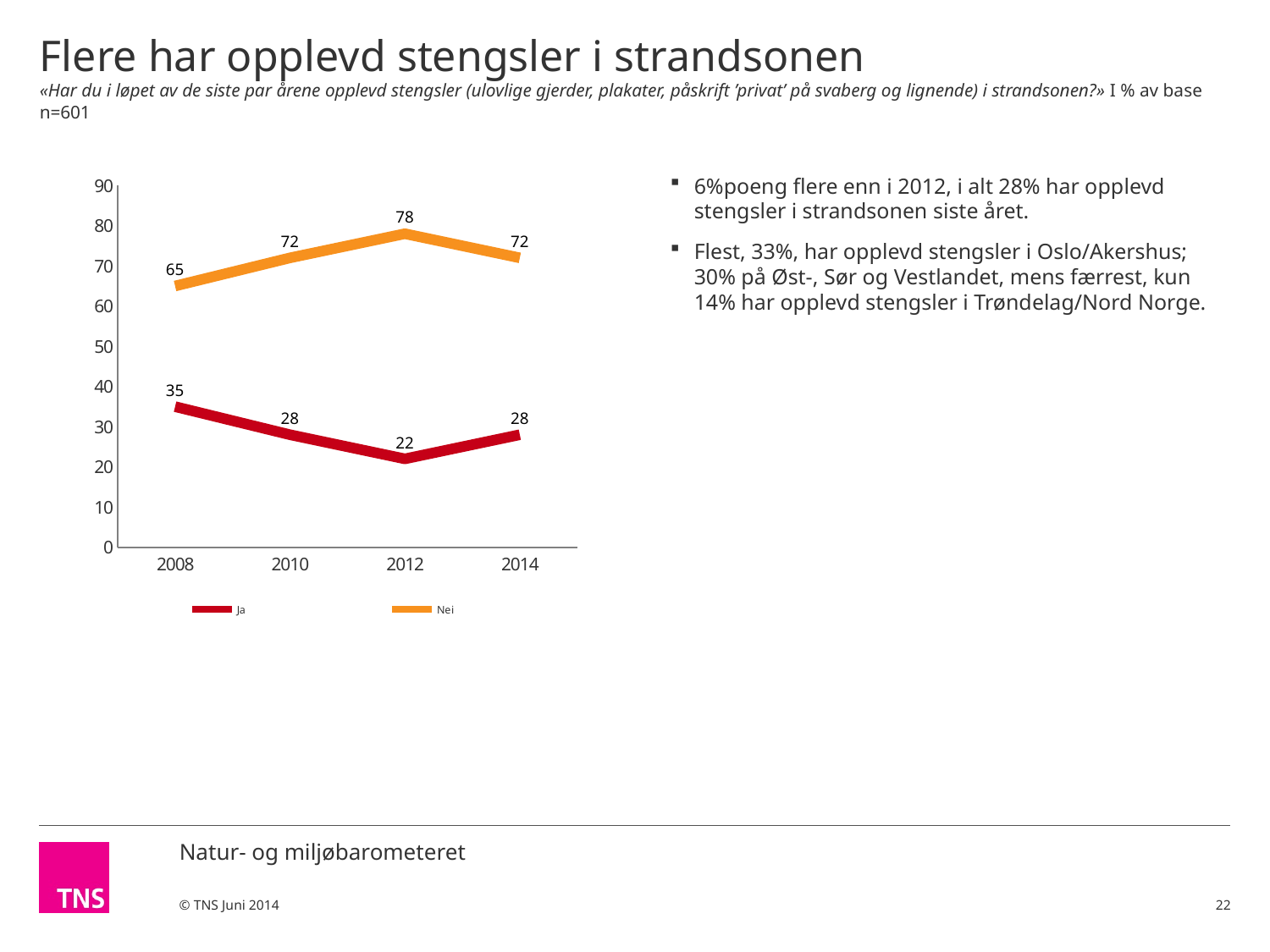
What is the value for "Nei" in 2012? 78 What kind of chart is shown on the slide? line chart Is the value for "Nei" in 2008 greater or less than 60? greater How many years are shown on the x axis? 4 Which is larger: the "Ja" value in 2008 or the "Ja" value in 2010? 2008 What is the difference between the "Nei" value in 2012 and the "Nei" value in 2008? 13 What is the value for "Ja" in 2014? 28 In which year is the "Ja" series lowest? 2012 How many series does the legend list? 2 What is the value for "Ja" in 2008? 35 Does the "Ja" series rise or fall from 2008 to 2012? fall In which year is the "Nei" series highest? 2012